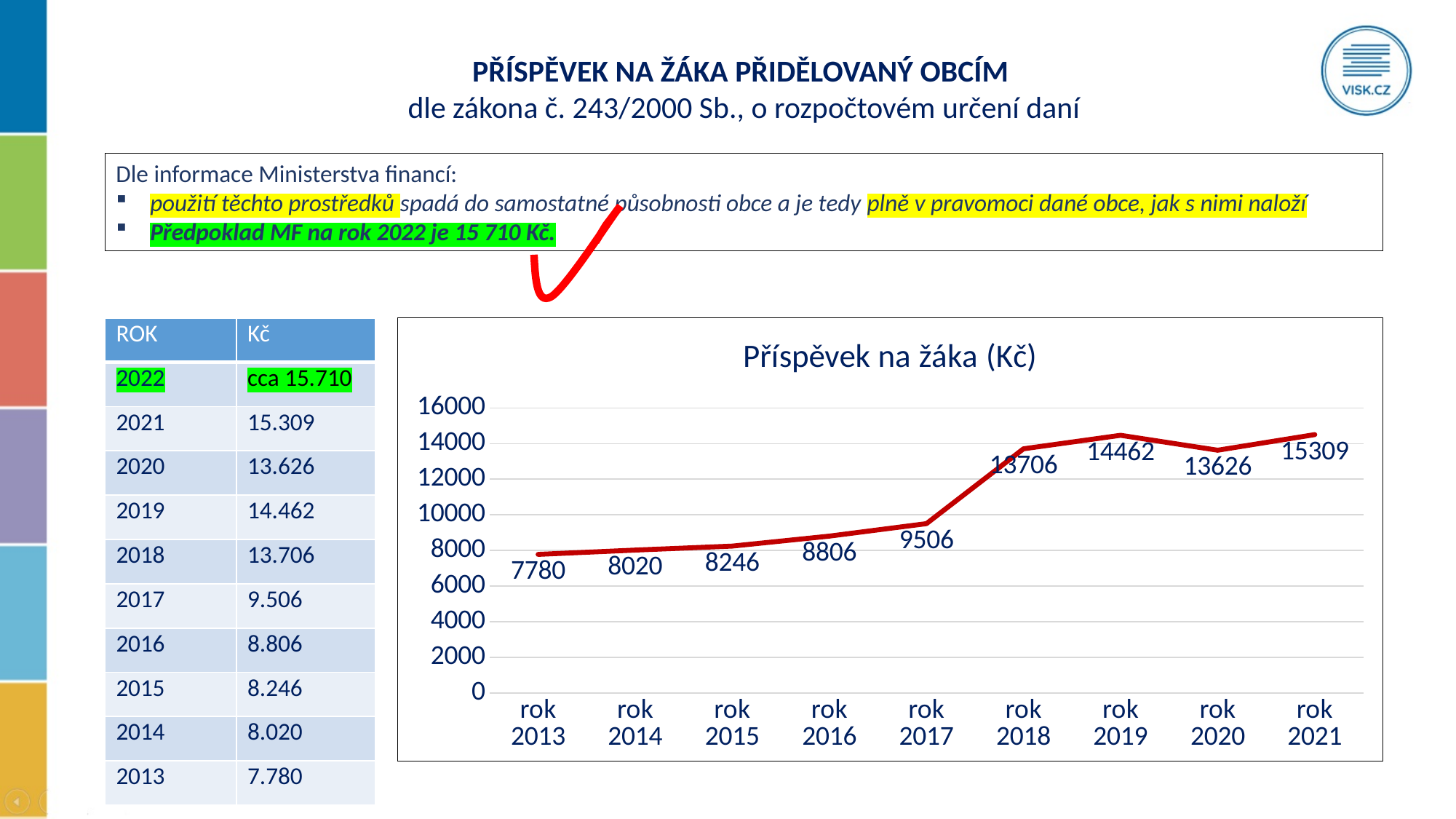
How many years are plotted on the x axis of the chart? 9 Does the value generally rise or fall from rok 2013 to rok 2021? rise What type of chart is shown on the slide? line chart Which is larger, the value for rok 2019 or the value for rok 2020? rok 2019 Which year has the lowest value in the chart? rok 2013 What is the value for rok 2020 in the chart? 13626 What is the title of the chart? Příspěvek na žáka (Kč) What is the difference between the values for rok 2021 and rok 2020? 1683 What is the value for rok 2013 in the chart? 7780 Which year has the highest value in the chart? rok 2021 What is the value for rok 2018 in the chart? 13706 What is the difference between the values for rok 2018 and rok 2017? 4200